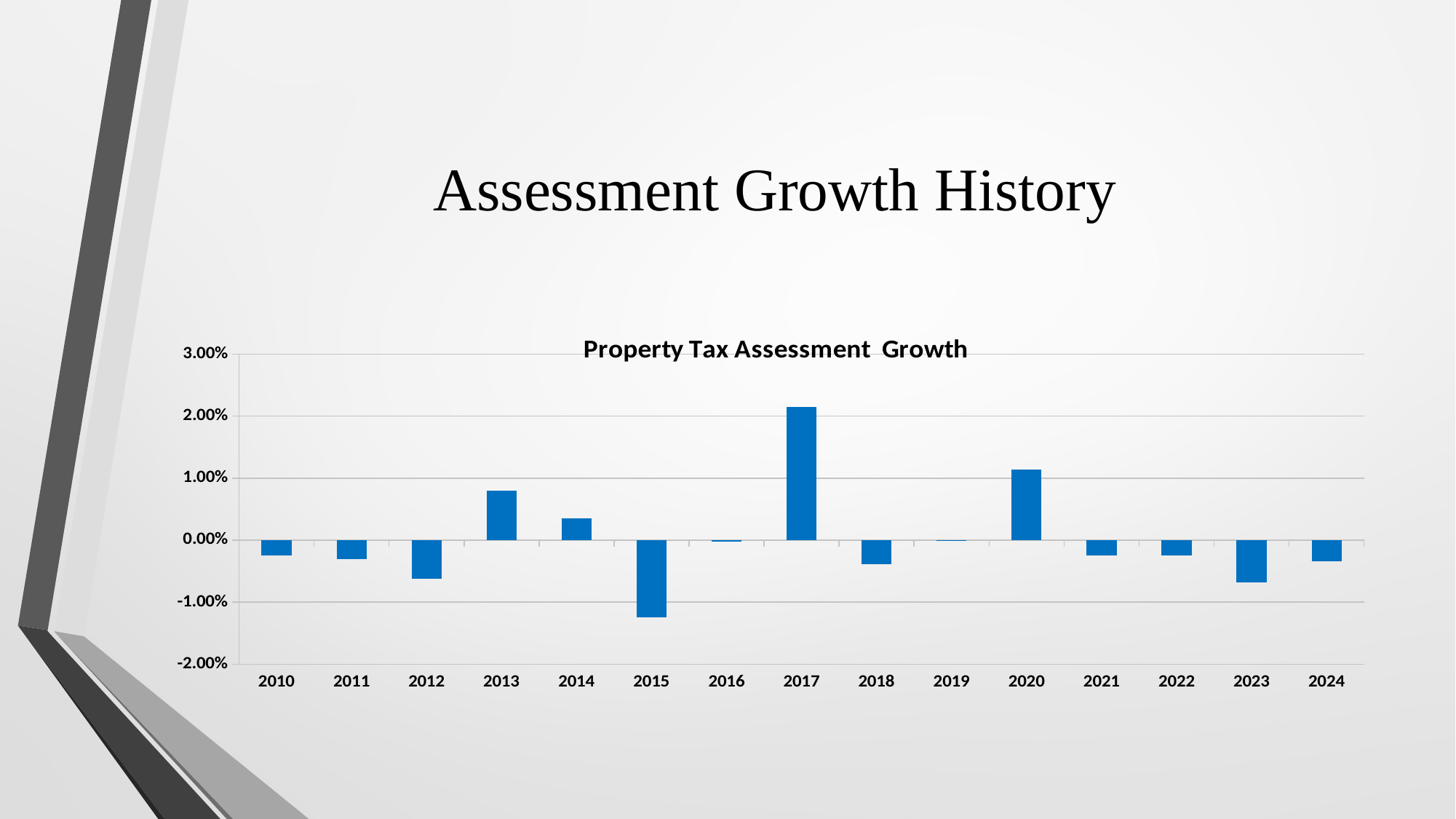
What is the title of the chart? Property Tax Assessment Growth Is the value for 2017 greater or less than 2.00%? greater Is the value for 2013 greater or less than 1.00%? less Is the value for 2020 greater or less than 1.00%? greater How many years are shown on the x axis of the chart? 15 Which year has the highest property tax assessment growth? 2017 What kind of chart is shown on the slide? bar chart Which year has the larger value, 2013 or 2014? 2013 What colour are the bars in the chart? blue Which year has the lowest property tax assessment growth? 2015